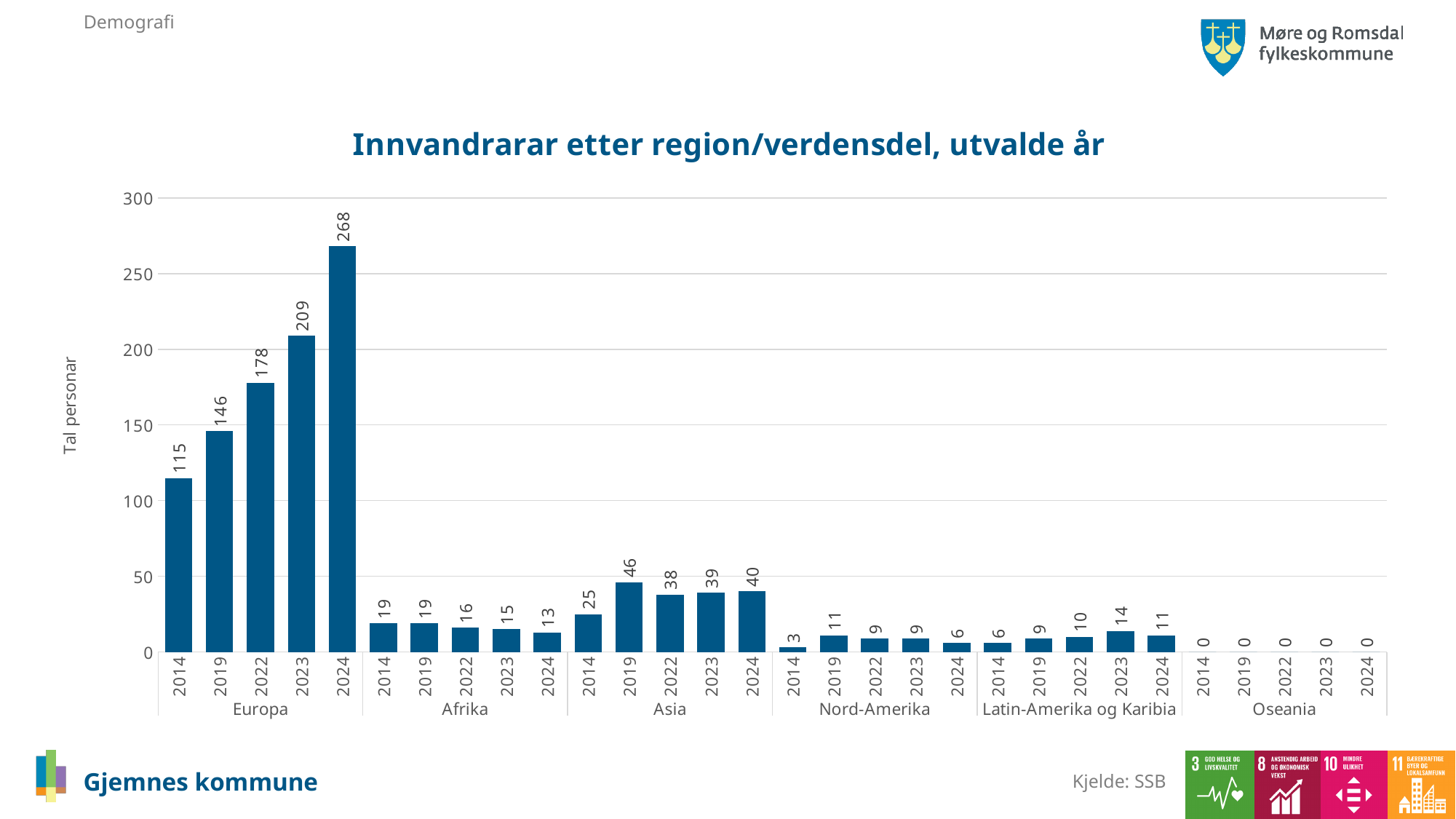
What is the difference between the Europa values for 2024 and 2014? 153 Is the value for Europa in 2023 greater or less than 200? greater What is the value for Latin-Amerika og Karibia in 2023? 14 Which region and year has the highest value on the chart? Europa, 2024 Which year has the lowest value within the Afrika group? 2024 What is the value for Nord-Amerika in 2014? 3 What is the value for Europa in 2024? 268 Do the values for Europa rise or fall from 2014 to 2024? rise How many region groups are shown on the x axis? 6 What kind of chart is this? bar chart What is the value for Asia in 2019? 46 Which is larger: Afrika in 2014 or Asia in 2014? Asia in 2014